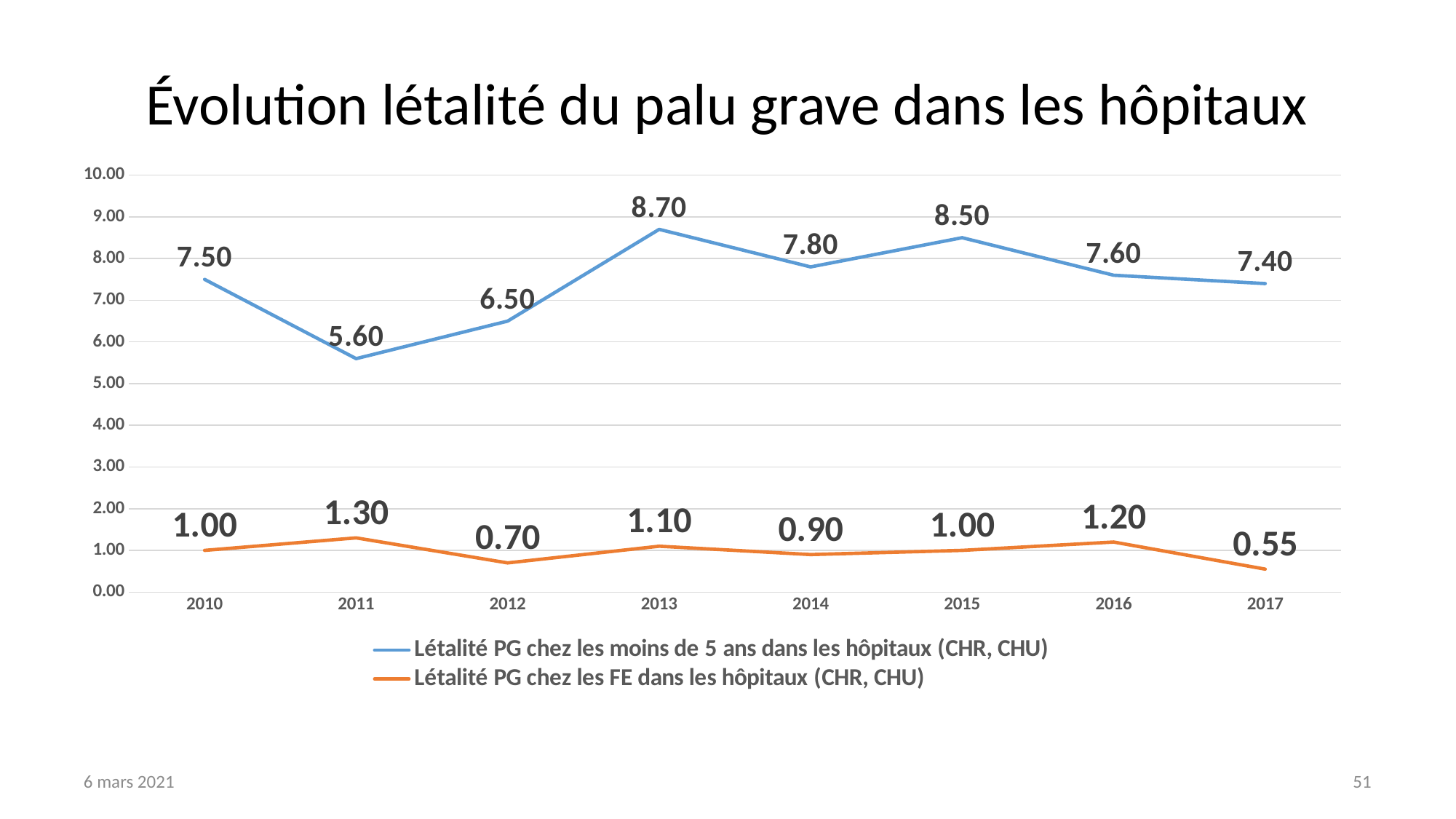
What is the difference between the 2013 and 2011 values for 'Létalité PG chez les moins de 5 ans dans les hôpitaux (CHR, CHU)'? 3.10 In which year is 'Létalité PG chez les moins de 5 ans dans les hôpitaux (CHR, CHU)' highest? 2013 What is the value for 'Létalité PG chez les moins de 5 ans dans les hôpitaux (CHR, CHU)' in 2013? 8.70 What kind of chart is shown on the slide? line chart What is the value for 'Létalité PG chez les moins de 5 ans dans les hôpitaux (CHR, CHU)' in 2011? 5.60 In which year is 'Létalité PG chez les FE dans les hôpitaux (CHR, CHU)' lowest? 2017 What is the value for 'Létalité PG chez les FE dans les hôpitaux (CHR, CHU)' in 2017? 0.55 Is the value for 'Létalité PG chez les moins de 5 ans dans les hôpitaux (CHR, CHU)' in 2015 greater or less than 8.00? greater How many series does the legend list? 2 How many years are shown on the x axis? 8 What is the title of the chart? Évolution létalité du palu grave dans les hôpitaux Which is larger for 'Létalité PG chez les FE dans les hôpitaux (CHR, CHU)': the value in 2011 or the value in 2016? 2011